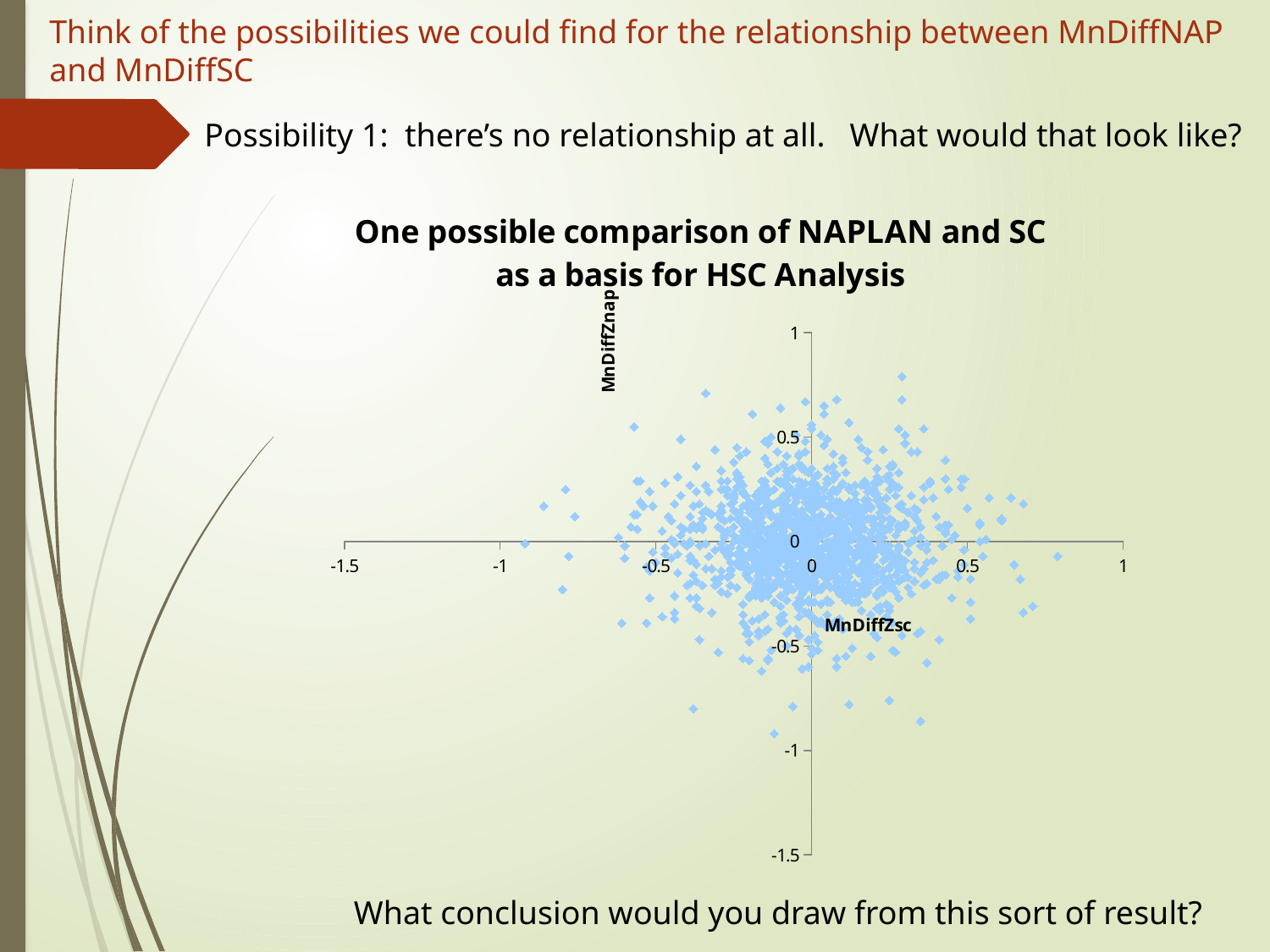
Do the plotted points show a clear rising or falling trend along the x axis? no clear trend What is the lowest tick value shown on the horizontal axis? -1.5 What is the highest tick value shown on the vertical axis? 1 What is the label on the horizontal axis of the chart? MnDiffZsc What kind of chart is shown on the slide? scatter plot What is the title of the chart? One possible comparison of NAPLAN and SC as a basis for HSC Analysis